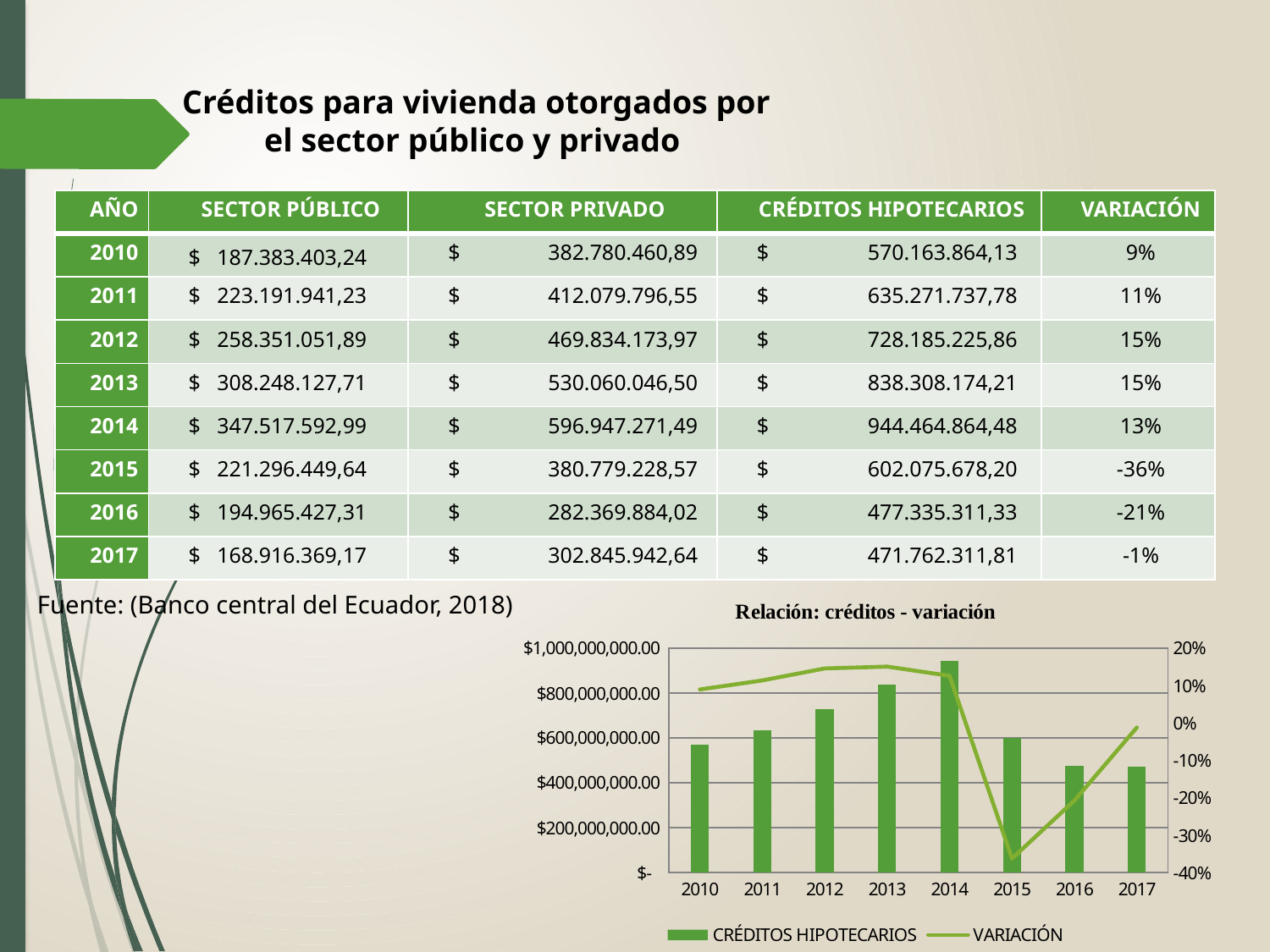
In the 'Relación: créditos - variación' chart, is the CRÉDITOS HIPOTECARIOS bar for 2014 greater or less than $800,000,000.00? greater How many years are shown on the x axis of the 'Relación: créditos - variación' chart? 8 In the 'Relación: créditos - variación' chart, is the CRÉDITOS HIPOTECARIOS bar for 2012 greater or less than $800,000,000.00? less According to the slide, what is the VARIACIÓN value for 2015? -36% In the 'Relación: créditos - variación' chart, which year has the tallest CRÉDITOS HIPOTECARIOS bar? 2014 What kind of chart is 'Relación: créditos - variación'? A bar chart combined with a line How many series does the legend of the 'Relación: créditos - variación' chart list? 2 In the 'Relación: créditos - variación' chart, in which year does the VARIACIÓN line reach its lowest point? 2015 What are the two legend entries of the 'Relación: créditos - variación' chart? CRÉDITOS HIPOTECARIOS and VARIACIÓN In the 'Relación: créditos - variación' chart, do the CRÉDITOS HIPOTECARIOS bars rise or fall from 2010 to 2014? rise In the 'Relación: créditos - variación' chart, is the CRÉDITOS HIPOTECARIOS bar for 2010 greater or less than $600,000,000.00? less In the 'Relación: créditos - variación' chart, which CRÉDITOS HIPOTECARIOS bar is taller, 2013 or 2016? 2013